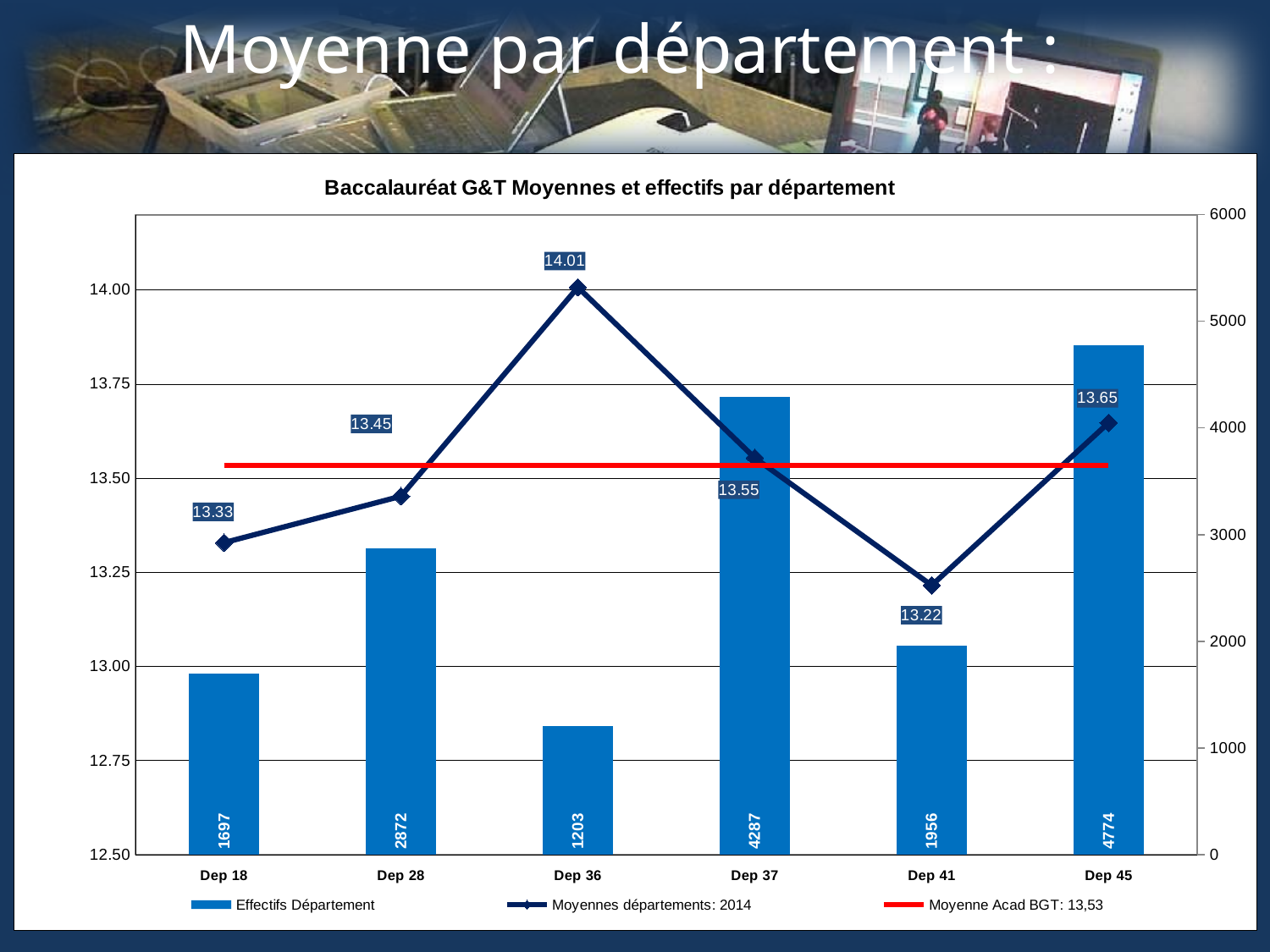
What is the title of the chart? Baccalauréat G&T Moyennes et effectifs par département Which department has the highest Effectifs Département value? Dep 45 How many departments are shown on the x axis? 6 What is the Moyennes départements: 2014 value for Dep 36? 14.01 What is the difference between the Moyennes départements: 2014 values for Dep 36 and Dep 41? 0.79 Which department has the lowest Moyennes départements: 2014 value? Dep 41 How many series does the legend list? 3 What is the Effectifs Département value for Dep 41? 1956 What is the difference between the Effectifs Département values for Dep 45 and Dep 36? 3571 What is the Effectifs Département value for Dep 37? 4287 Which has a higher Moyennes départements: 2014 value, Dep 18 or Dep 28? Dep 28 What value does the legend give for Moyenne Acad BGT? 13,53